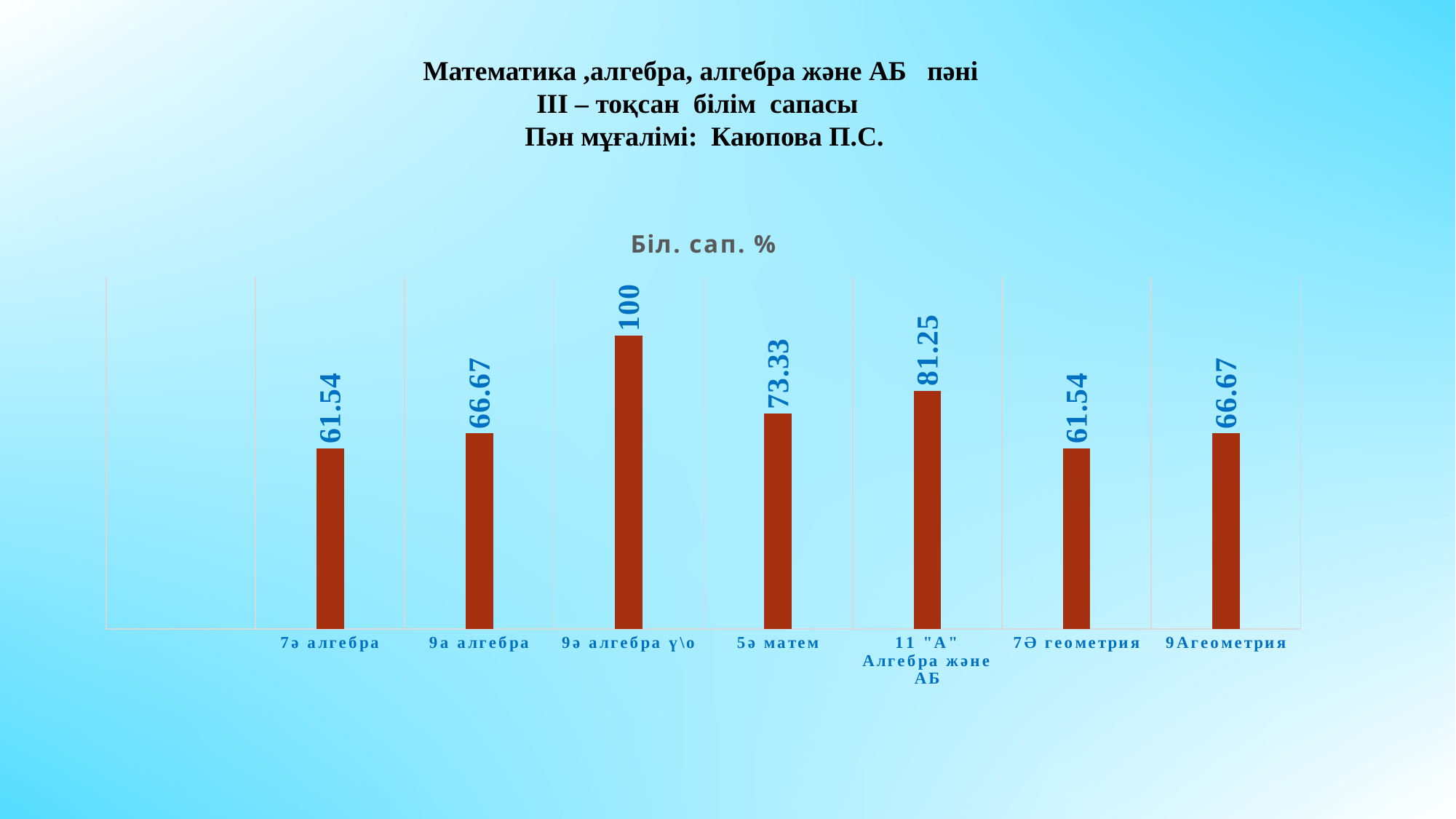
Which is larger, the value for 5ә матем or the value for 7Ә геометрия? 5ә матем How many categories are shown in the chart? 7 What is the value for 11 "А" Алгебра және АБ? 81.25 What is the difference between the values for 9ә алгебра ү\о and 5ә матем? 26.67 What is the value for 5ә матем? 73.33 What is the value for 9Агеометрия? 66.67 What is the value for 7ә алгебра? 61.54 Which category has the highest value? 9ә алгебра ү\о What is the difference between the values for 11 "А" Алгебра және АБ and 9а алгебра? 14.58 What kind of chart is shown on the slide? Bar chart What is the value for 9ә алгебра ү\о? 100 What is the lowest value shown in the chart? 61.54